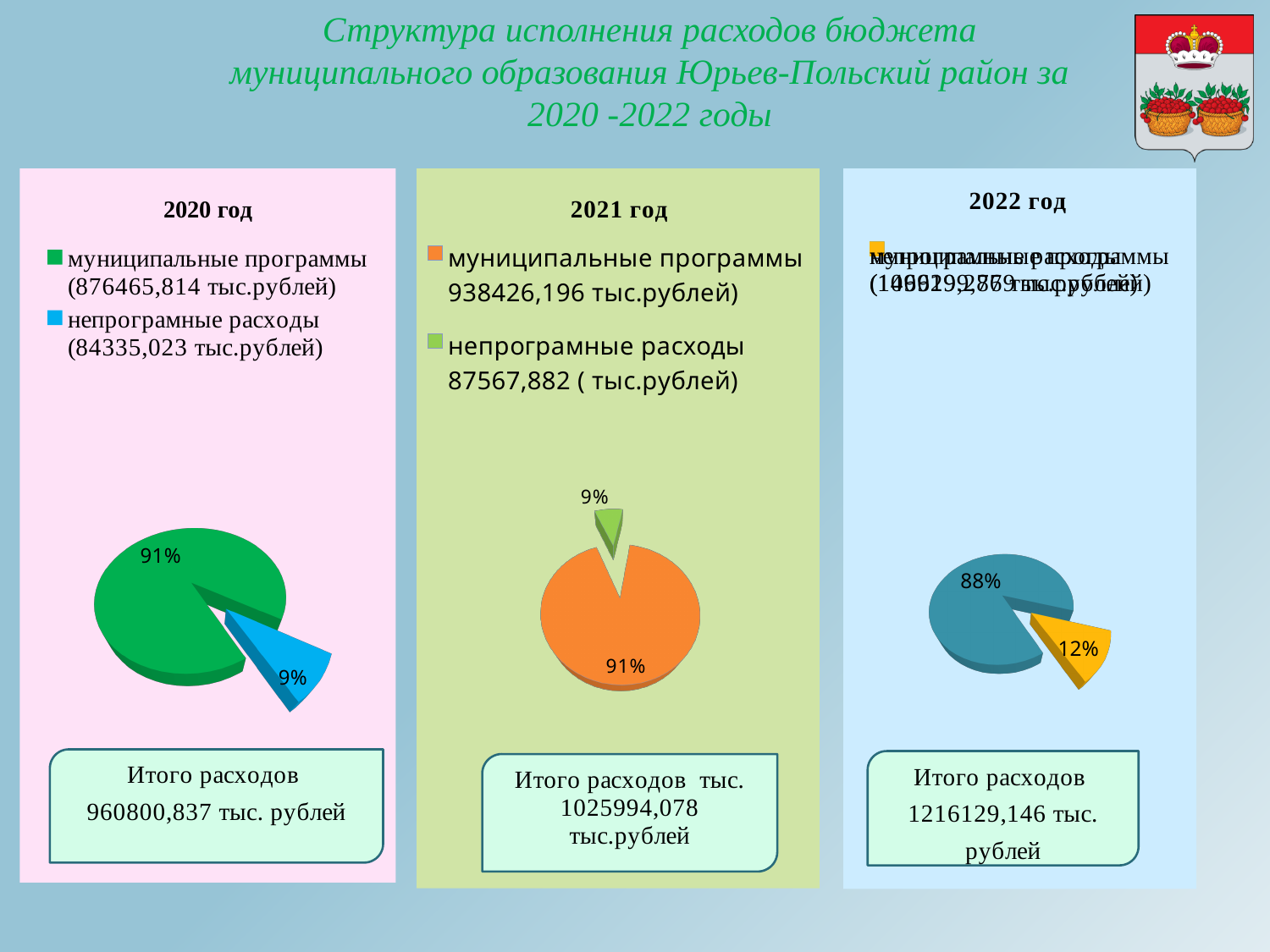
In the 2022 pie chart, what is the difference in percentage points between the larger and smaller slice? 76 In the 2021 pie chart, which category has the larger share: municipal programs or non-program expenses? municipal programs What kind of chart is used for the 2020 year? pie chart In the 2020 pie chart, what share of expenses is shown for non-program expenses (непрограмные расходы)? 9% In the 2022 pie chart, what is the percentage of the largest slice? 88% In the 2020 pie chart, what share of expenses is shown for municipal programs (муниципальные программы)? 91% How many entries does the legend of the 2020 chart list? 2 In the 2022 pie chart, what is the percentage of the smallest slice? 12% In the 2021 pie chart, what share is shown for municipal programs (муниципальные программы)? 91% In the 2020 pie chart, what colour is the slice for municipal programs? green How many slices does the 2020 pie chart have? 2